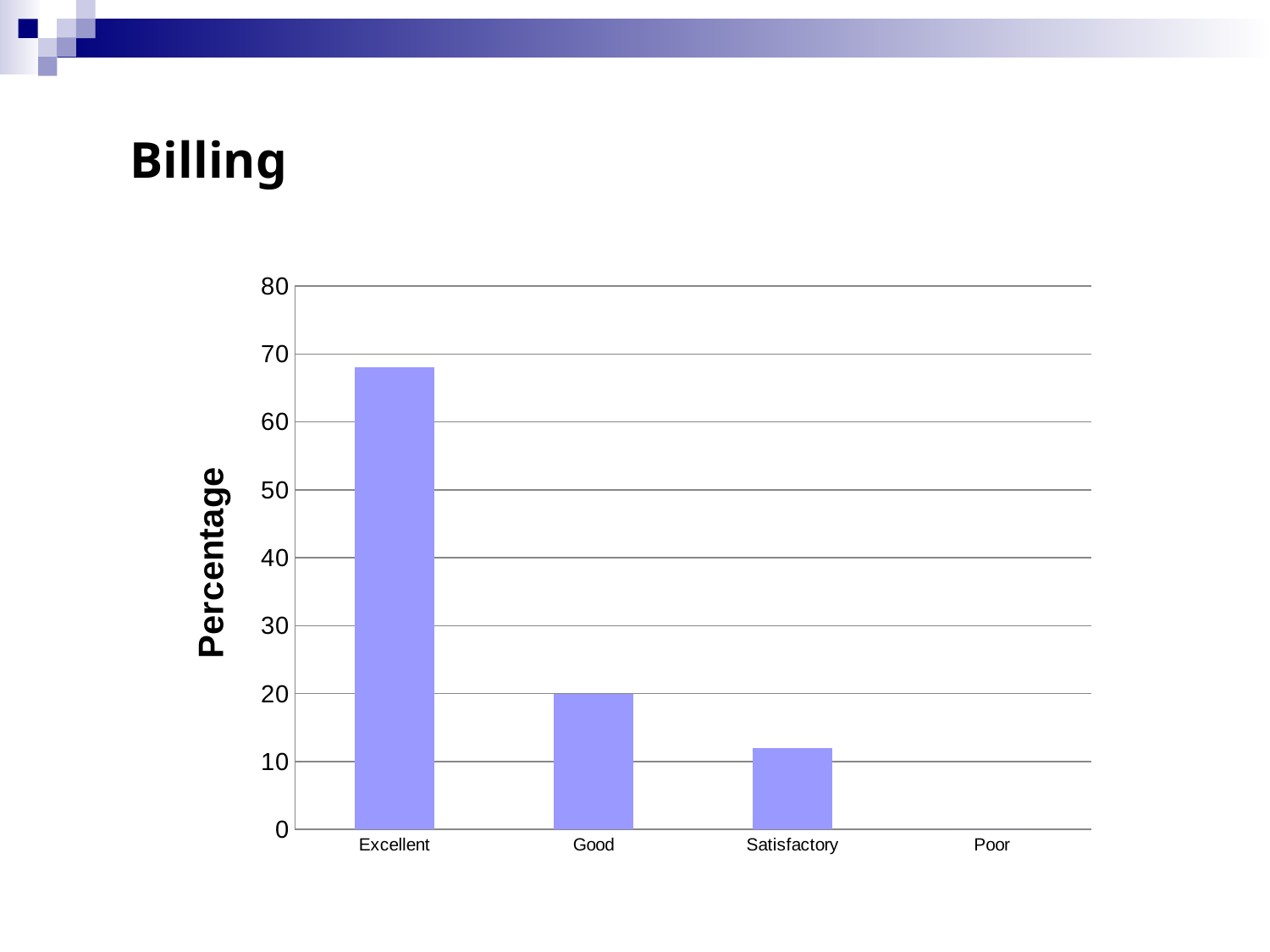
Is the value for Excellent greater or less than 60? greater Which category has the lowest value in the chart? Poor Do the values rise or fall moving from Excellent to Poor along the x axis? fall Is the value for Satisfactory greater or less than 20? less Is the value for Excellent greater or less than 70? less Which is larger, the value for Good or the value for Satisfactory? Good Which category has the highest value in the chart? Excellent What kind of chart is shown on the slide? bar chart What is the label on the vertical axis of the chart? Percentage How many categories are shown on the x axis of the chart? 4 What is the title of the slide containing the chart? Billing